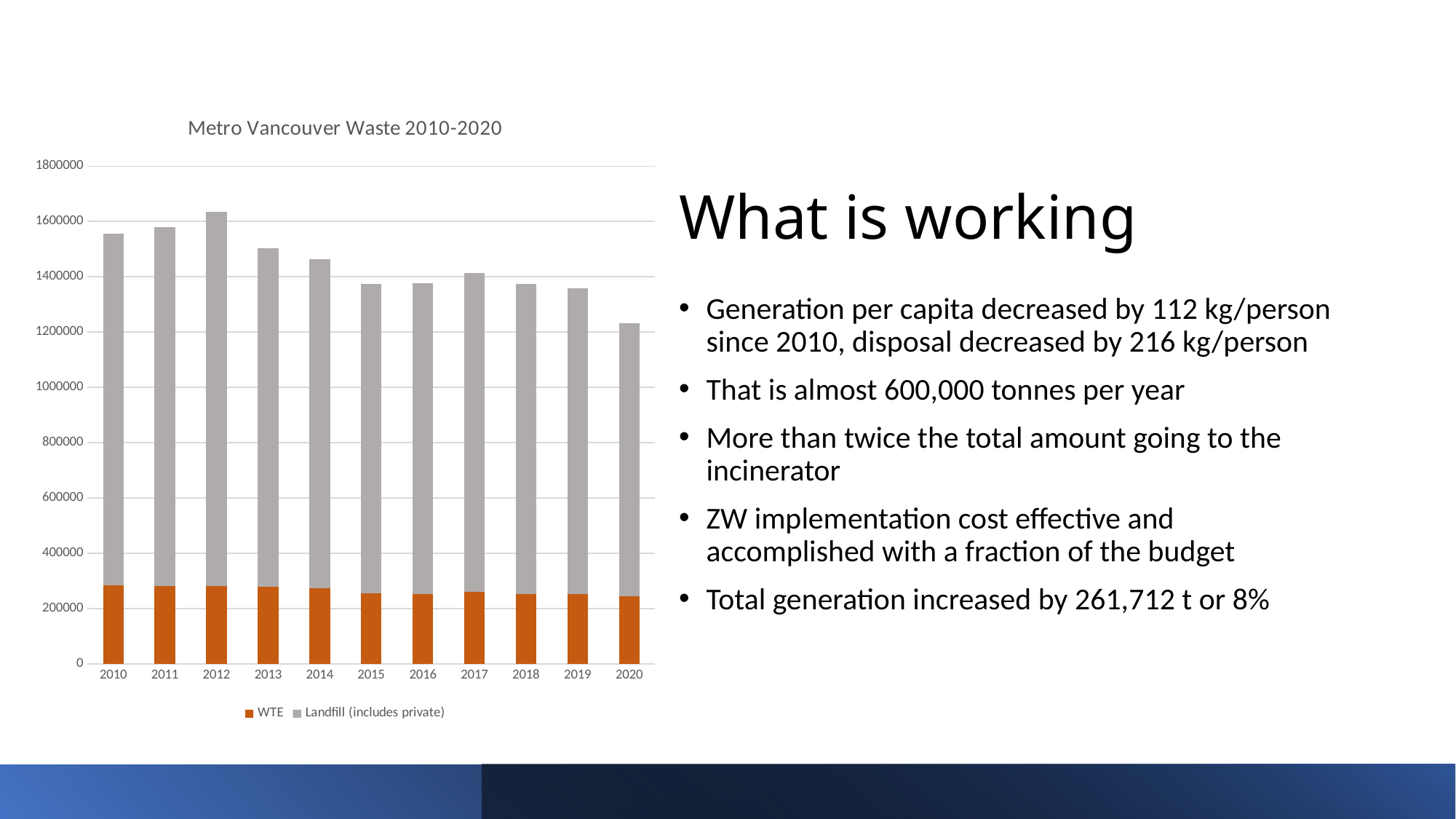
Which year has the larger total bar, 2014 or 2015? 2014 Which year has the lowest total bar in the chart? 2020 Overall, do the total bars rise or fall from 2010 to 2020? fall What are the two series named in the chart's legend? WTE and Landfill (includes private) How many years are shown on the x axis of the chart? 11 Which year has the highest total bar in the chart? 2012 What is the title of the chart? Metro Vancouver Waste 2010-2020 Is the WTE value for 2010 greater or less than 200000? greater What kind of chart is shown on the slide? Stacked bar chart Is the total bar for 2012 greater or less than 1600000? greater Is the total bar for 2020 greater or less than 1400000? less How many series does the chart's legend list? 2